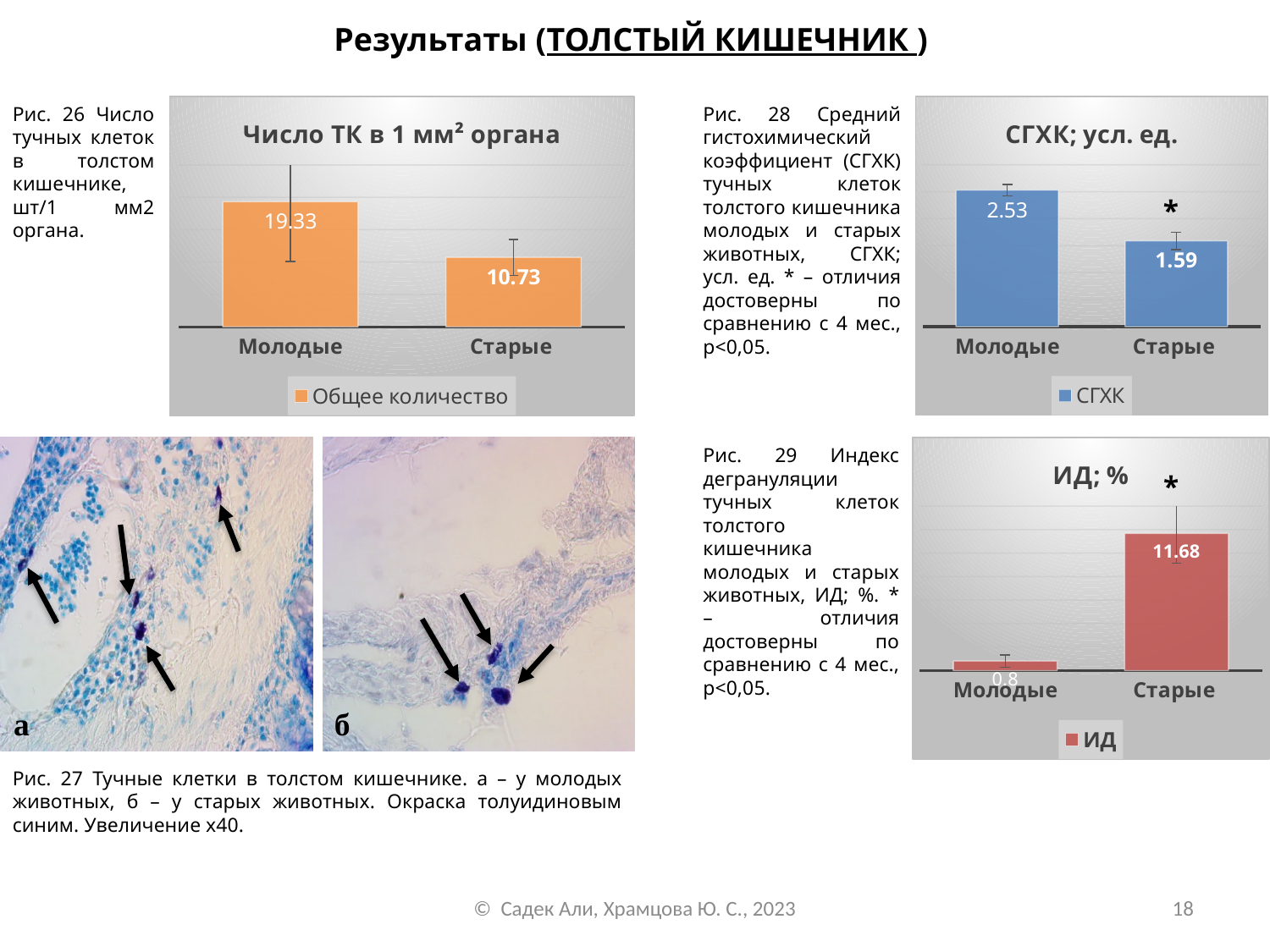
In the chart titled 'ИД; %', which is larger, the value for Молодые or the value for Старые? Старые In the chart titled 'Число ТК в 1 мм² органа', what is the difference between the values for Молодые and Старые? 8.6 In the chart titled 'СГХК; усл. ед.', which category has the highest value? Молодые In the chart titled 'СГХК; усл. ед.', what is the difference between the values for Молодые and Старые? 0.94 In the chart titled 'ИД; %', what is the value for Молодые? 0.8 In the chart titled 'СГХК; усл. ед.', what is the value for Старые? 1.59 In the chart titled 'СГХК; усл. ед.', how many categories are shown on the x axis? 2 In the chart titled 'ИД; %', what is the value for Старые? 11.68 In the chart titled 'Число ТК в 1 мм² органа', what is the value for Старые? 10.73 What kind of chart is the chart titled 'Число ТК в 1 мм² органа'? bar chart In the chart titled 'ИД; %', which category has the lowest value? Молодые In the chart titled 'Число ТК в 1 мм² органа', what is the value for Молодые? 19.33